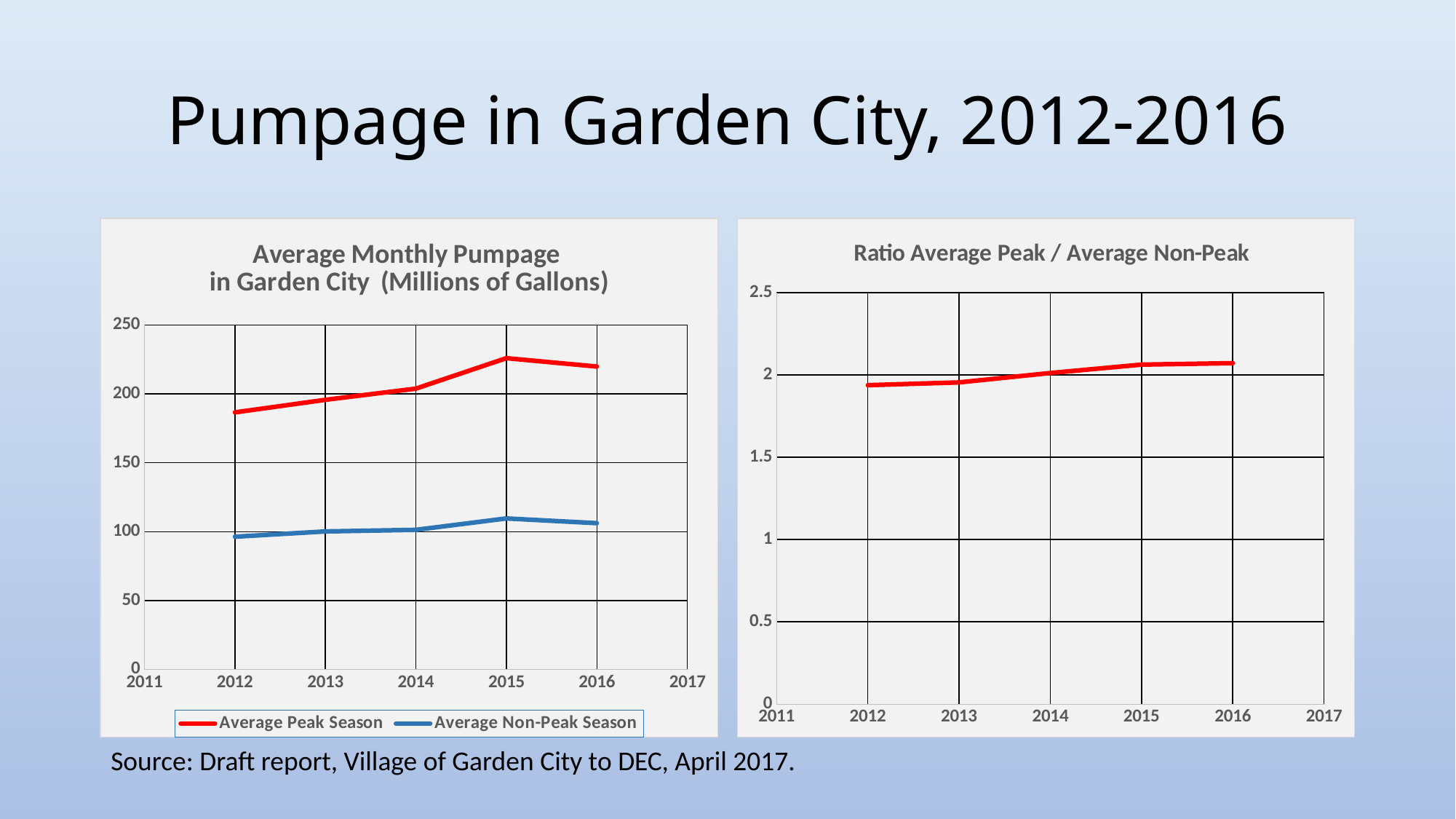
In the 'Average Monthly Pumpage in Garden City' chart, what colour is the Average Non-Peak Season line? Blue In the 'Average Monthly Pumpage in Garden City' chart, which year has the lowest Average Peak Season value? 2012 In the 'Average Monthly Pumpage in Garden City' chart, is the Average Non-Peak Season value for 2012 greater or less than 100? less In the 'Average Monthly Pumpage in Garden City' chart, how many years have data points plotted? 5 In the 'Average Monthly Pumpage in Garden City' chart, is the Average Peak Season value for 2015 greater or less than 200? greater In the 'Average Monthly Pumpage in Garden City' chart, which series is higher in every year, Average Peak Season or Average Non-Peak Season? Average Peak Season What kind of chart is the 'Average Monthly Pumpage in Garden City' chart on the left? Line chart In the 'Ratio Average Peak / Average Non-Peak' chart, does the ratio generally rise or fall from 2012 to 2016? Rise In the 'Ratio Average Peak / Average Non-Peak' chart, is the value for 2016 greater or less than 2? greater In the 'Average Monthly Pumpage in Garden City' chart, which year has the highest Average Peak Season value? 2015 In the 'Average Monthly Pumpage in Garden City' chart, how many series does the legend list? 2